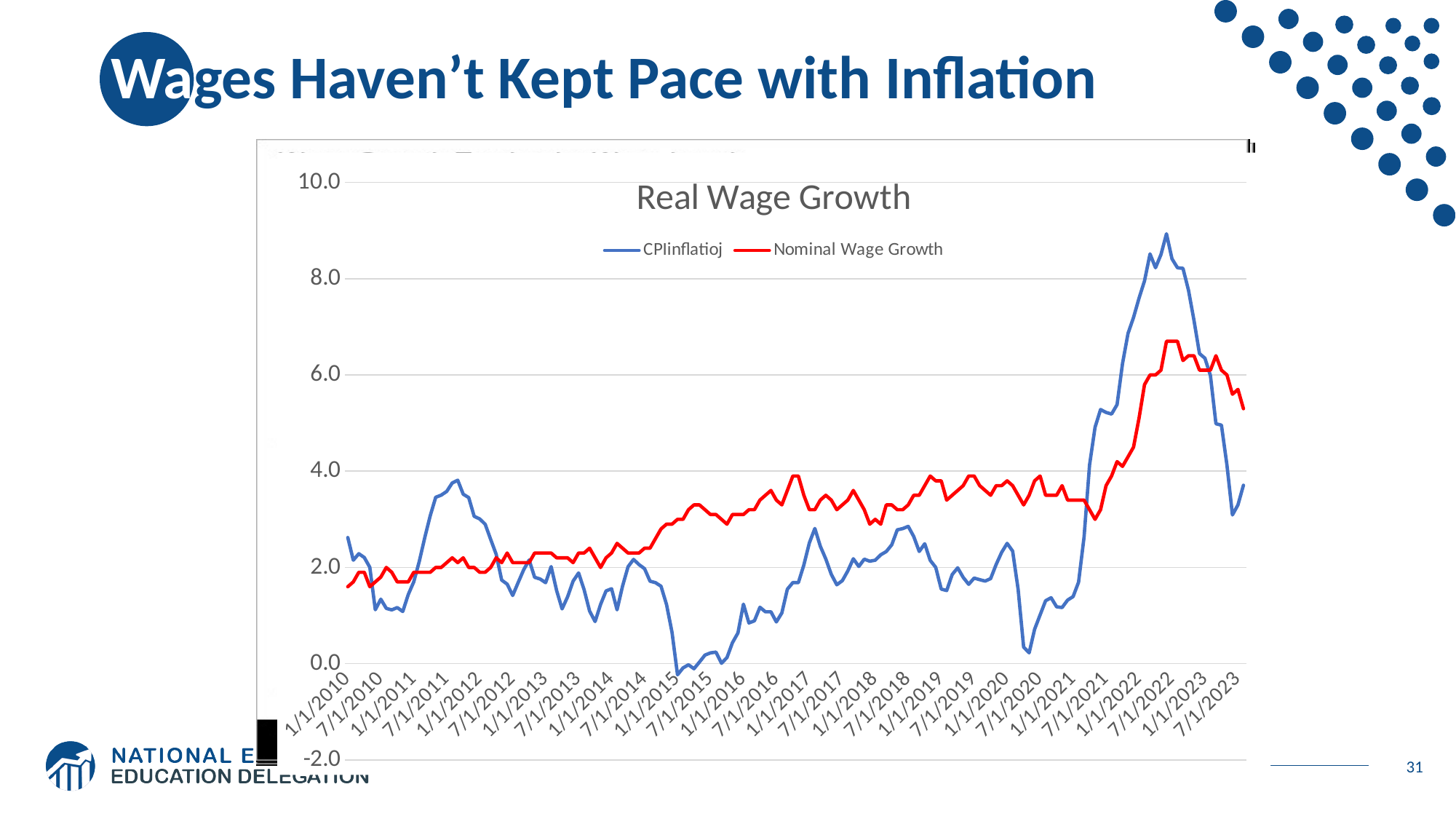
Is the value of the Nominal Wage Growth line at 1/1/2010 greater or less than 2.0? less Is the value of the CPIinflatioj line around 1/1/2015 greater or less than 2.0? less Is the peak value of the Nominal Wage Growth line, around 7/1/2022, greater or less than 6.0? greater What is the title of the chart? Real Wage Growth Does the Nominal Wage Growth line generally rise or fall from 1/1/2010 to 7/1/2022? rise What kind of chart is shown on the slide? line chart Around 7/1/2022, which series has the higher value, CPIinflatioj or Nominal Wage Growth? CPIinflatioj How many series does the legend of the chart list? 2 Around 1/1/2015, which series has the higher value, CPIinflatioj or Nominal Wage Growth? Nominal Wage Growth What colour is the Nominal Wage Growth line in the chart? red